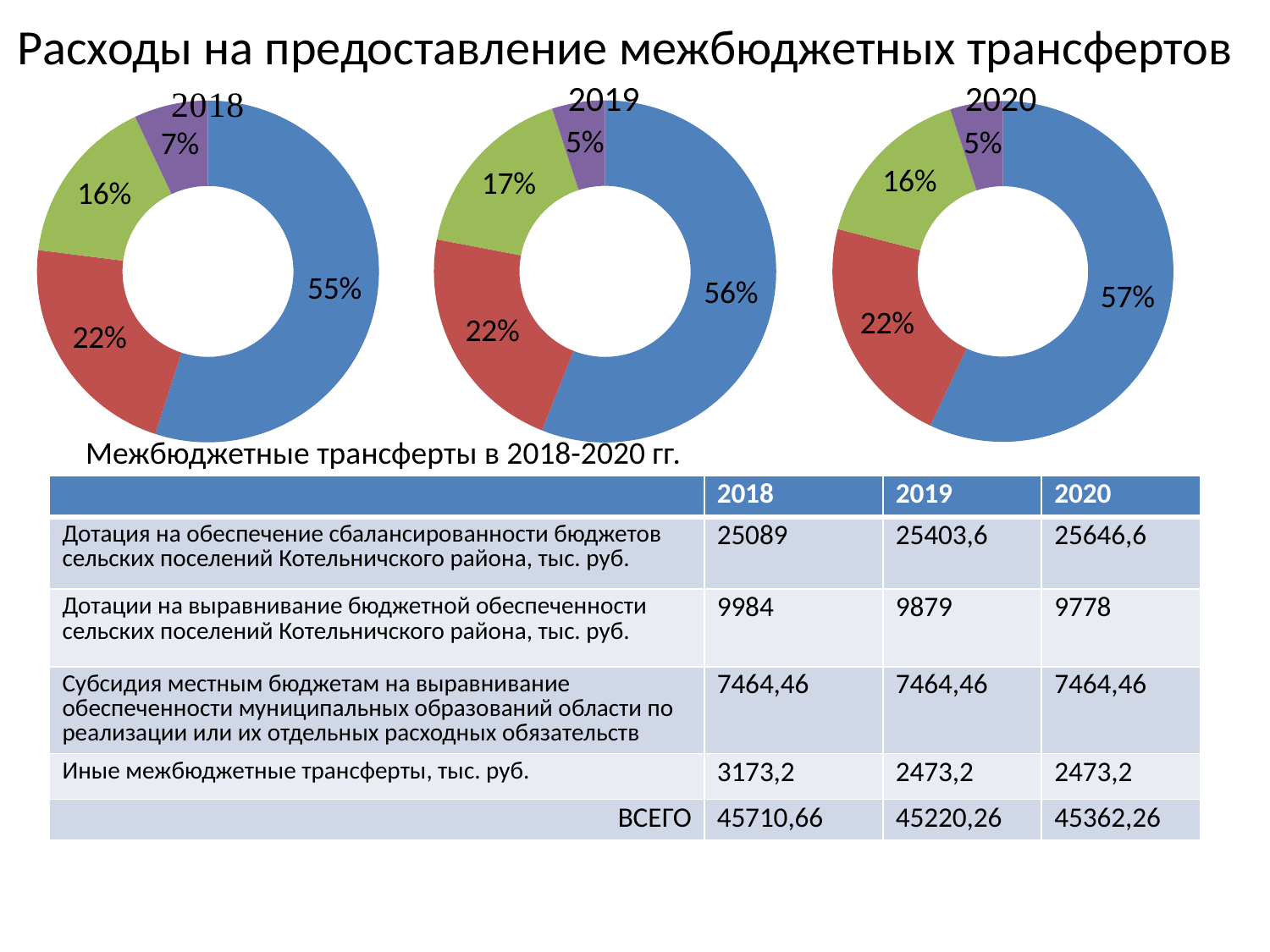
In the 2019 chart, what is the percentage of the smallest slice? 5% How many slices does the 2018 chart have? 4 What kind of chart is used for the 2018, 2019 and 2020 charts? doughnut chart In the 2018 chart, what percentage is shown on the purple slice? 7% In the 2018 chart, what is the percentage of the largest slice? 55% Does the share of the largest slice rise or fall from the 2018 chart to the 2020 chart? rise In the 2020 chart, what is the percentage of the largest slice? 57% How many doughnut charts are shown on the slide? 3 In the 2020 chart, what percentage is shown on the red slice? 22% In the 2019 chart, what percentage is shown on the green slice? 17% What is the difference between the largest slice in the 2019 chart and the largest slice in the 2018 chart? 1% Which chart has the larger biggest slice, 2018 or 2020? 2020